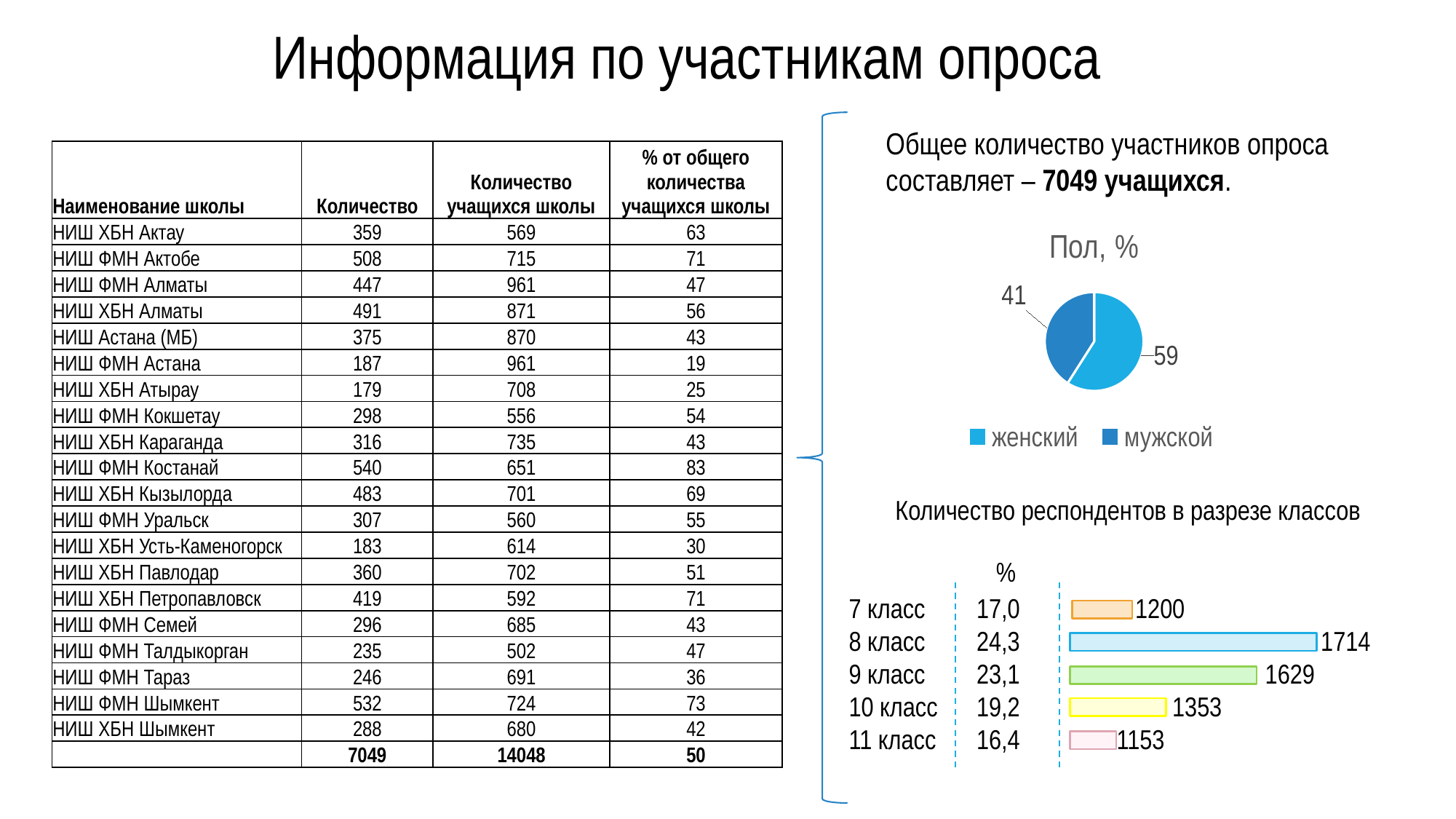
In the pie chart titled "Пол, %", what is the difference between the женский and мужской values? 18 In the pie chart titled "Пол, %", which category has the larger share? женский In the bar chart titled "Количество респондентов в разрезе классов", what percentage is shown for 10 класс? 19,2 In the bar chart titled "Количество респондентов в разрезе классов", what is the number of respondents for 8 класс? 1714 How many entries does the legend of the pie chart titled "Пол, %" list? 2 In the pie chart titled "Пол, %", what is the value for мужской? 41 In the bar chart titled "Количество респондентов в разрезе классов", what is the difference between the number of respondents for 9 класс and 7 класс? 429 In the pie chart titled "Пол, %", what is the value for женский? 59 What kind of chart is the chart titled "Пол, %"? pie chart How many classes are shown in the bar chart titled "Количество респондентов в разрезе классов"? 5 In the bar chart titled "Количество респондентов в разрезе классов", which class has the highest number of respondents? 8 класс In the bar chart titled "Количество респондентов в разрезе классов", which class has the lowest number of respondents? 11 класс